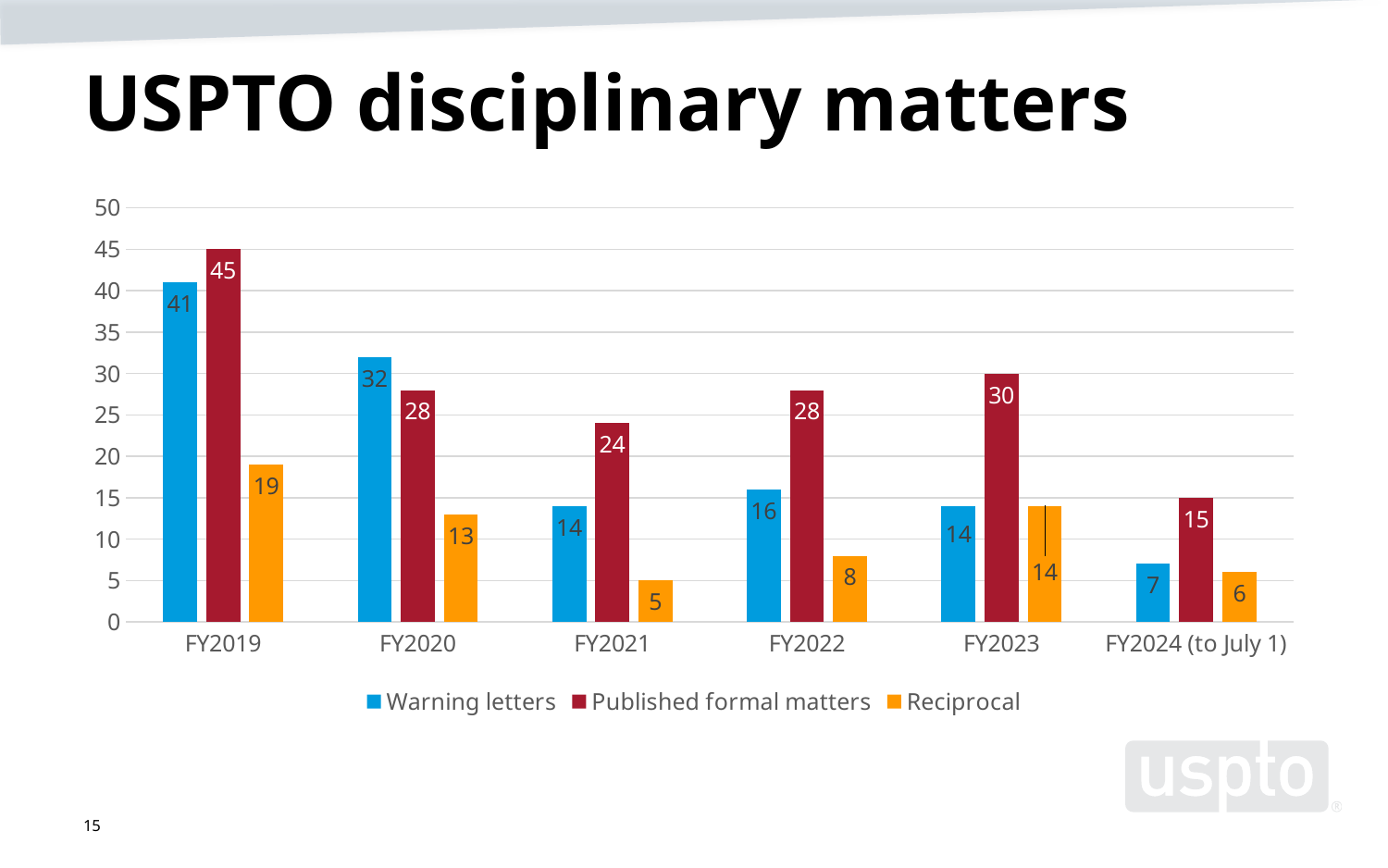
In FY2020, which is larger: Warning letters or Published formal matters? Warning letters Do the Warning letters values generally rise or fall from FY2019 to FY2024 (to July 1)? Fall What is the value for Warning letters in FY2019? 41 What is the value for Reciprocal in FY2021? 5 What is the difference between Published formal matters and Warning letters in FY2022? 12 Which fiscal year has the highest value for Published formal matters? FY2019 How many series does the legend list? 3 What is the value for Published formal matters in FY2023? 30 What kind of chart is shown on the slide? Bar chart How many fiscal year categories are shown on the x axis? 6 Which fiscal year has the lowest value for Warning letters? FY2024 (to July 1) What is the title of the slide containing the chart? USPTO disciplinary matters